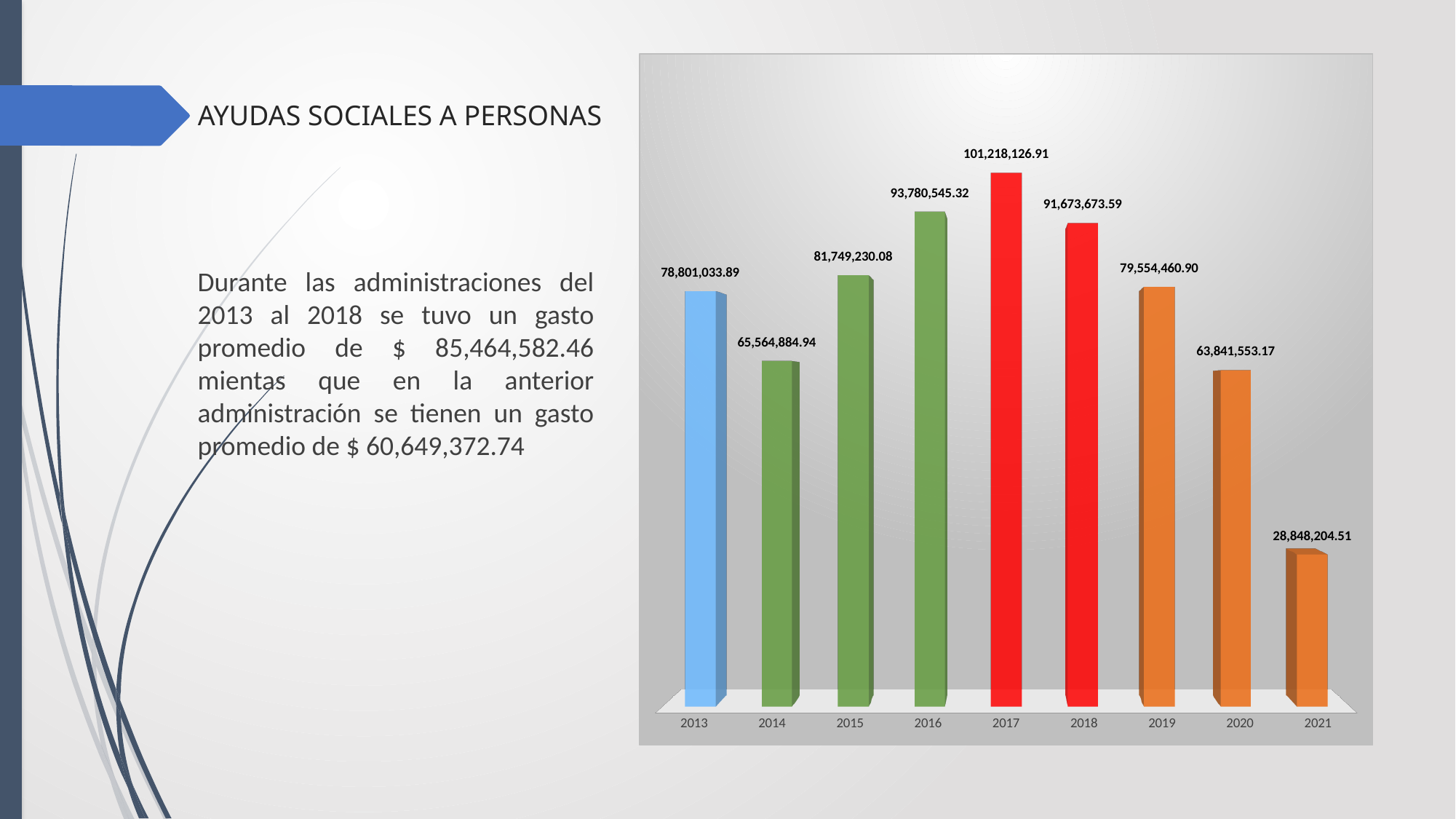
Which year has the lowest value in the chart? 2021 Do the values rise or fall from 2017 to 2021? fall How many years are shown on the x axis of the chart? 9 What is the value for 2014 in the chart? 65,564,884.94 What is the value for 2017 in the chart? 101,218,126.91 What colour are the bars for 2017 and 2018? red What is the difference between the values for 2017 and 2021? 72,369,922.40 Which is larger, the value for 2013 or the value for 2019? 2019 Which year has the highest value in the chart? 2017 What is the value for 2021 in the chart? 28,848,204.51 What is the difference between the values for 2016 and 2015? 12,031,315.24 What kind of chart is shown on the slide? bar chart